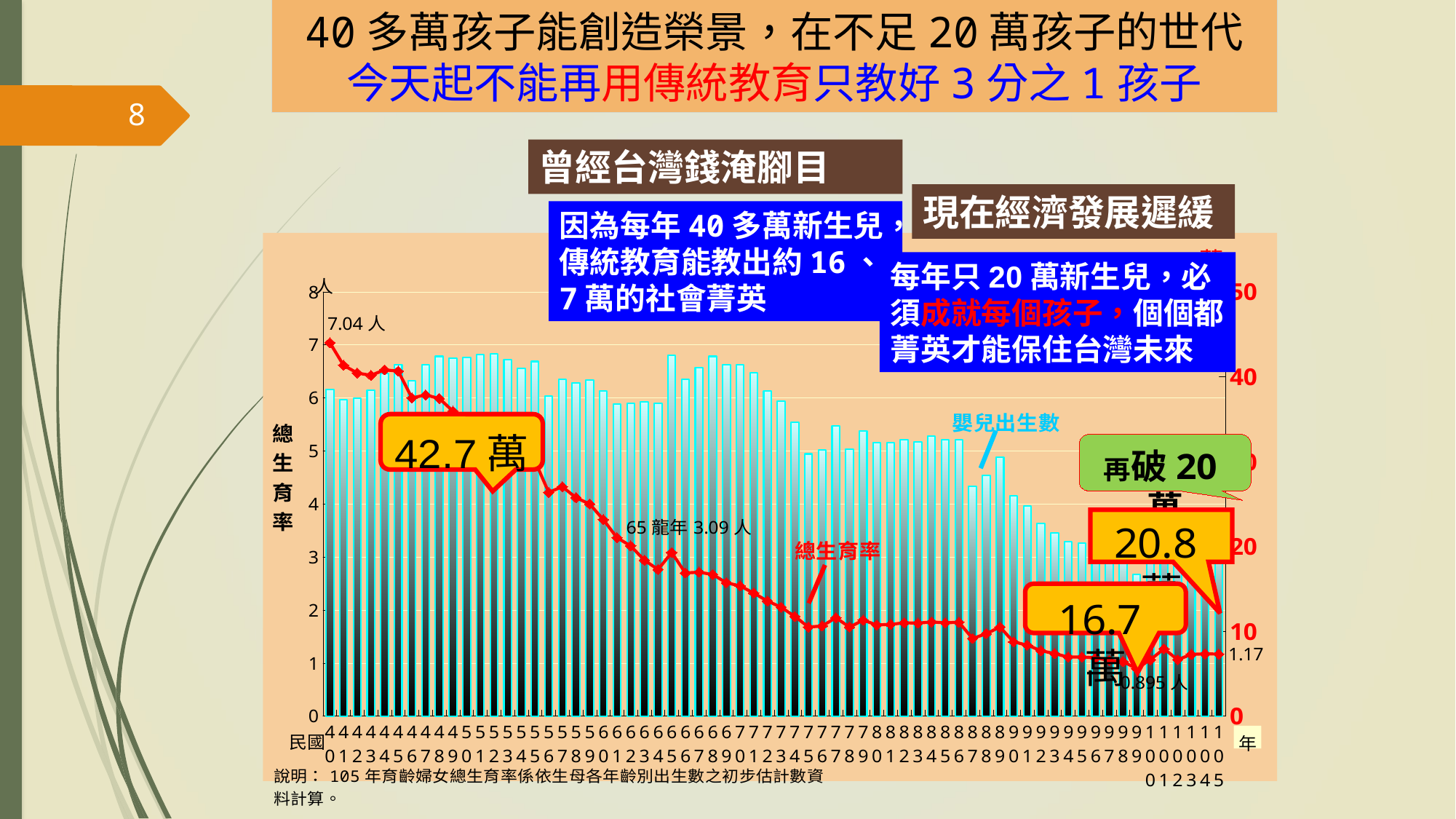
What are the two data series shown on the chart? 嬰兒出生數 and 總生育率 What is the lowest number of births shown in a callout on the chart? 16.7 萬 Which is larger, the fertility rate labelled at 民國 40 or the one labelled for 65 龍年? 民國 40 (7.04 人) Does the total fertility rate line rise or fall overall from left to right? Fall What is the peak number of births shown in the callout on the chart? 42.7 萬 What is the lowest total fertility rate value labelled on the line? 0.895 人 What total fertility rate is labelled for 65 龍年? 3.09 人 What is the total fertility rate (總生育率) labelled at the start of the line, in 民國 40? 7.04 人 What kind of chart is shown on the slide? A bar chart combined with a line chart What is the difference between the fertility rate labelled at 民國 40 (7.04) and the value labelled at 民國 105 (1.17)? 5.87 What total fertility rate value is labelled at the right end of the line (民國 105)? 1.17 Is the number of births (嬰兒出生數) in 民國 40 greater or less than 30 on the right axis? greater